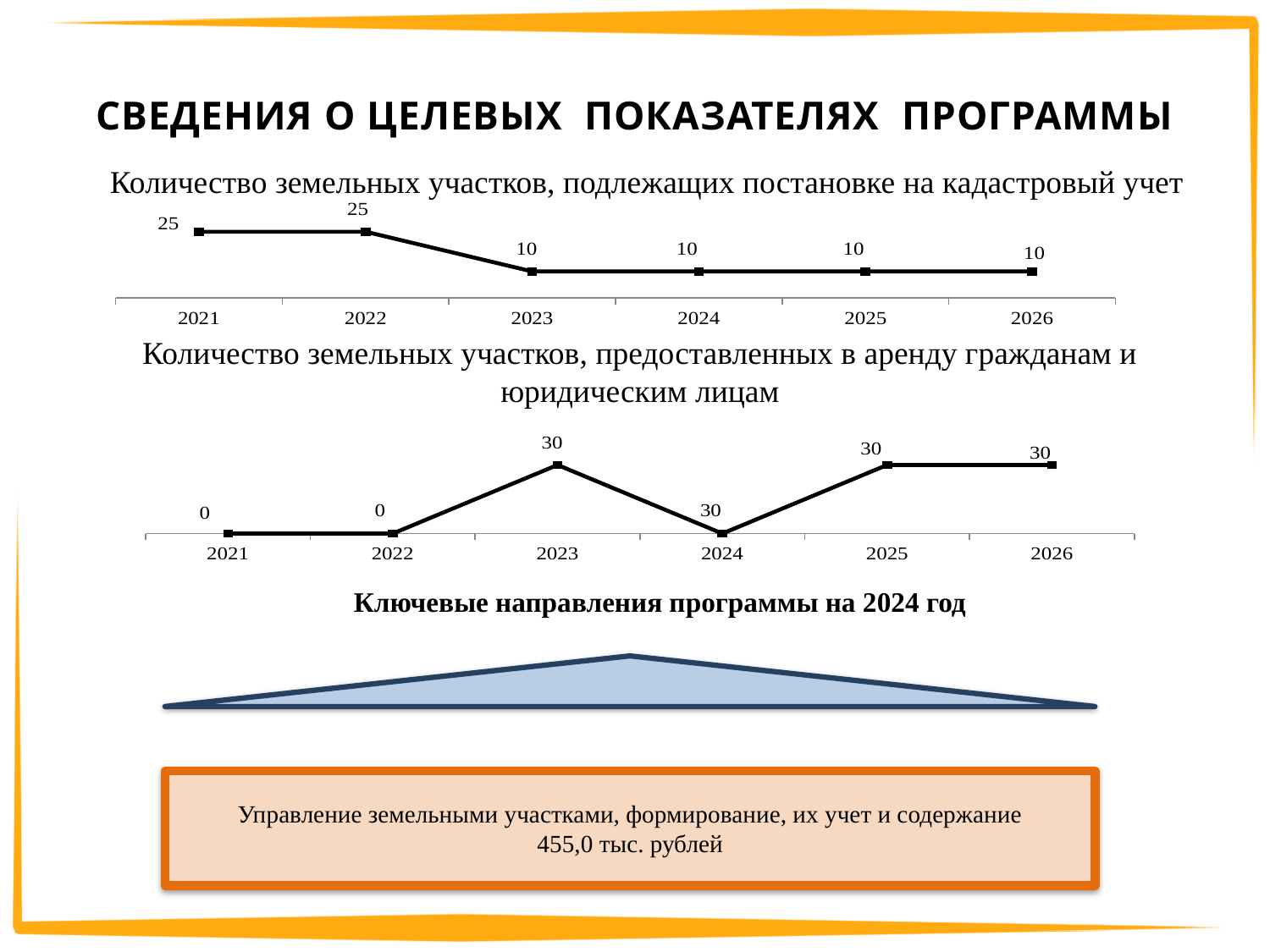
In the bottom chart (Количество земельных участков, предоставленных в аренду гражданам и юридическим лицам), which is larger, the value for 2022 or the value for 2023? 2023 In the top chart (Количество земельных участков, подлежащих постановке на кадастровый учет), what is the value for 2021? 25 In the bottom chart (Количество земельных участков, предоставленных в аренду гражданам и юридическим лицам), what is the value for 2025? 30 In the top chart (Количество земельных участков, подлежащих постановке на кадастровый учет), what is the value for 2024? 10 In the bottom chart (Количество земельных участков, предоставленных в аренду гражданам и юридическим лицам), what is the difference between the values for 2026 and 2021? 30 What kind of chart is the top chart (Количество земельных участков, подлежащих постановке на кадастровый учет)? line chart In the top chart (Количество земельных участков, подлежащих постановке на кадастровый учет), what is the difference between the values for 2022 and 2023? 15 In the bottom chart (Количество земельных участков, предоставленных в аренду гражданам и юридическим лицам), what is the value for 2021? 0 In the top chart (Количество земельных участков, подлежащих постановке на кадастровый учет), do the values rise or fall from 2021 to 2026? fall In the top chart (Количество земельных участков, подлежащих постановке на кадастровый учет), which is larger, the value for 2021 or the value for 2026? 2021 In the top chart (Количество земельных участков, подлежащих постановке на кадастровый учет), how many years are plotted on the x axis? 6 How many charts are shown on the slide? 2